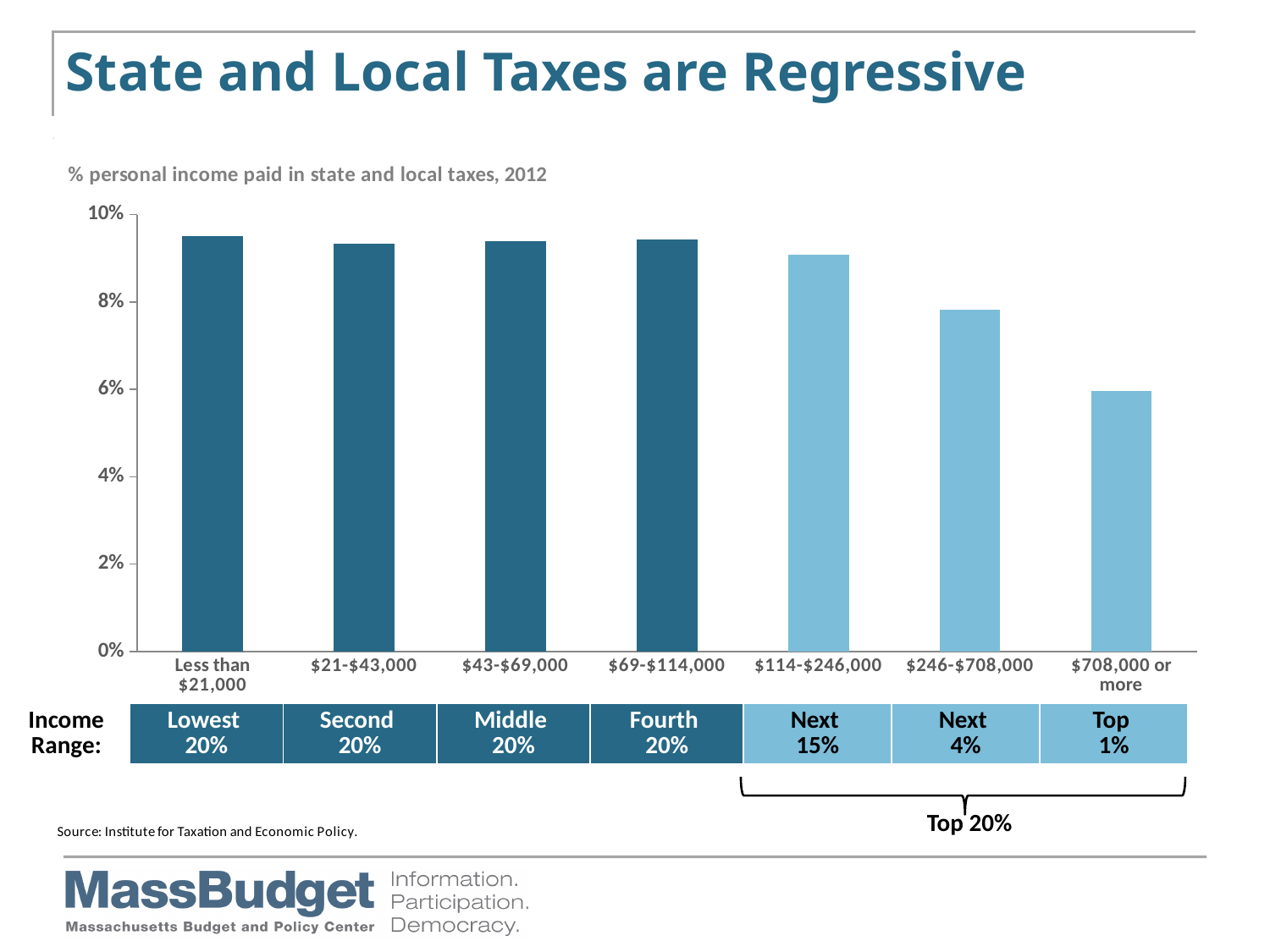
How many income-range categories are plotted in the chart? 7 Is the value for the $708,000 or more income range greater or less than 8%? less Is the value for the Less than $21,000 income range greater or less than 8%? greater Which is larger: the value for $246-$708,000 or the value for $708,000 or more? $246-$708,000 Which is larger: the value for $69-$114,000 or the value for $246-$708,000? $69-$114,000 Which income range has the lowest share of personal income paid in state and local taxes? $708,000 or more Is the value for the $246-$708,000 income range greater or less than 6%? greater What kind of chart is shown on the slide? bar chart Do the values generally rise or fall as income range increases from left to right across the chart? fall What is the title of the slide? State and Local Taxes are Regressive What source is cited for the chart data? Institute for Taxation and Economic Policy